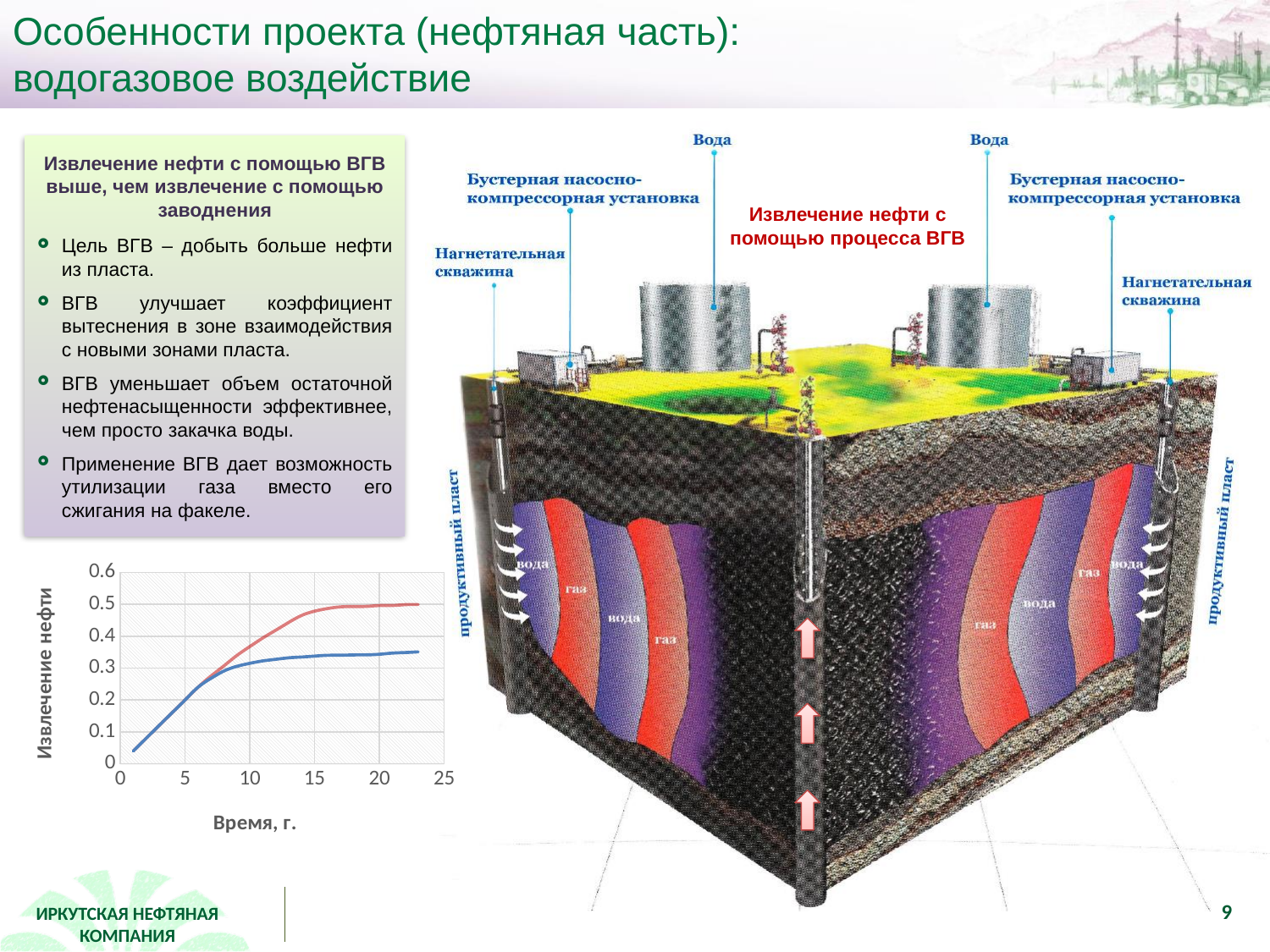
Is the value of the blue line at 20 years greater or less than 0.3? greater What is the title of the vertical axis of the chart? Извлечение нефти How many lines are plotted on the chart in the lower left of the slide? 2 Is the value of the red line at 20 years greater or less than 0.4? greater What is the title of the horizontal axis of the chart? Время, г. At 20 years, which line has the higher value, the red line or the blue line? red line What is the highest tick value shown on the vertical axis of the chart? 0.6 Do the values of the blue line rise or fall as time increases along the x axis? rise Do the values of the red line rise or fall as time increases along the x axis? rise Is the value of the blue line at 20 years greater or less than 0.4? less What kind of chart is shown in the lower left of the slide? line chart